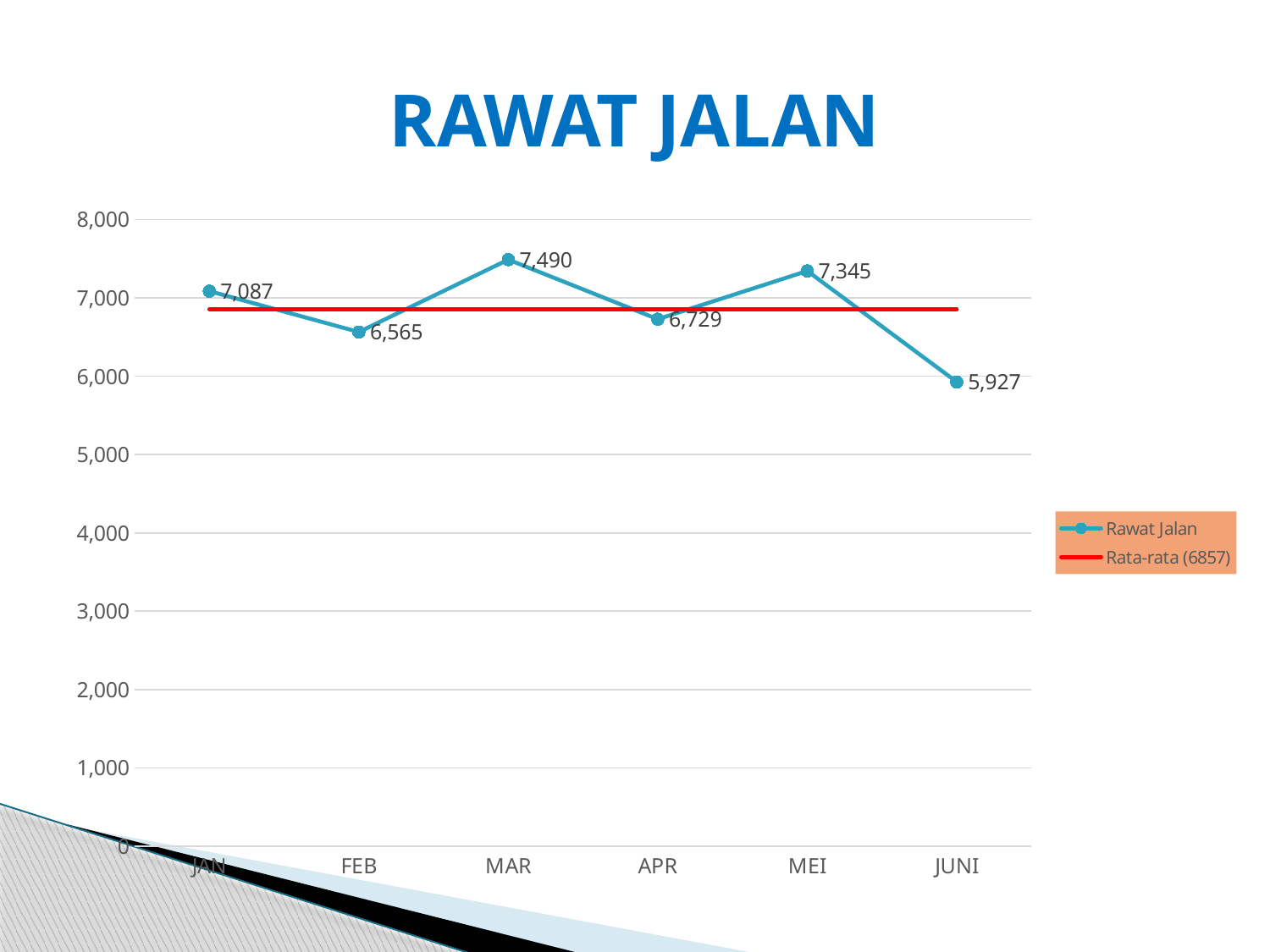
How many series does the legend list? 2 Which month has the highest Rawat Jalan value? MAR What is the difference between the Rawat Jalan values for MAR and FEB? 925 What average value is given in the legend for the Rata-rata line? 6857 Is the Rawat Jalan value for MEI greater or less than 7,000? greater What is the Rawat Jalan value for MAR? 7,490 How many months are plotted on the x axis? 6 What kind of chart is shown on the slide? line chart What is the Rawat Jalan value for FEB? 6,565 What is the Rawat Jalan value for JUNI? 5,927 Which is larger, the Rawat Jalan value for JAN or for APR? JAN Which month has the lowest Rawat Jalan value? JUNI